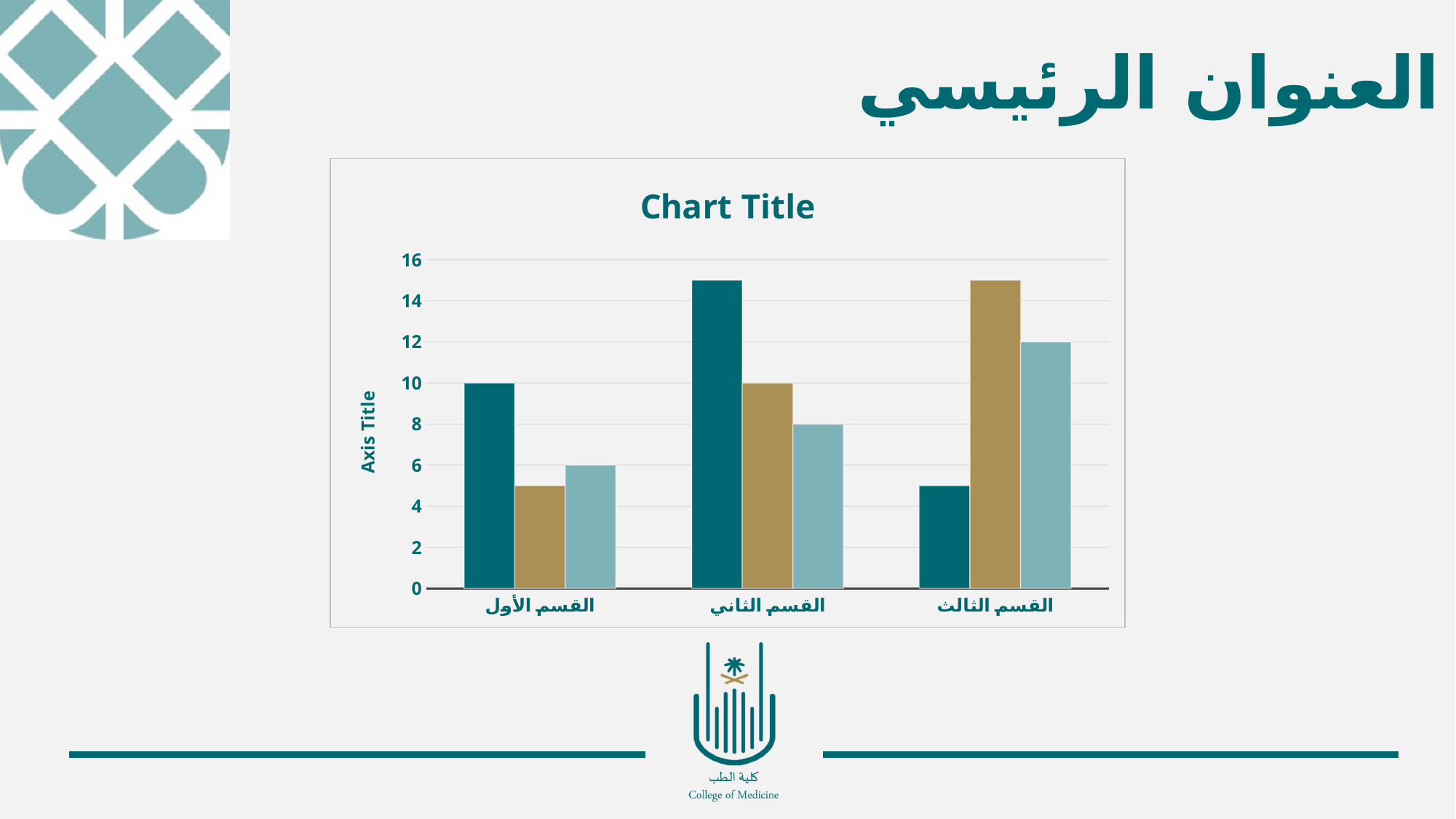
What is the value of the light teal bar for القسم الثاني? 8 Which category has the tallest dark teal bar? القسم الثاني What is the value of the light teal bar for القسم الأول? 6 What is the value of the dark teal bar for القسم الأول? 10 Is the value of the dark teal bar for القسم الثاني greater or less than 14? greater What is the title of the chart? Chart Title What is the value of the gold bar for القسم الثاني? 10 What is the value of the light teal bar for القسم الثالث? 12 How many categories are shown on the x axis of the chart? 3 Which is larger for القسم الثالث, the gold bar or the dark teal bar? the gold bar What kind of chart is shown on the slide? bar chart Is the value of the gold bar for القسم الأول greater or less than 6? less